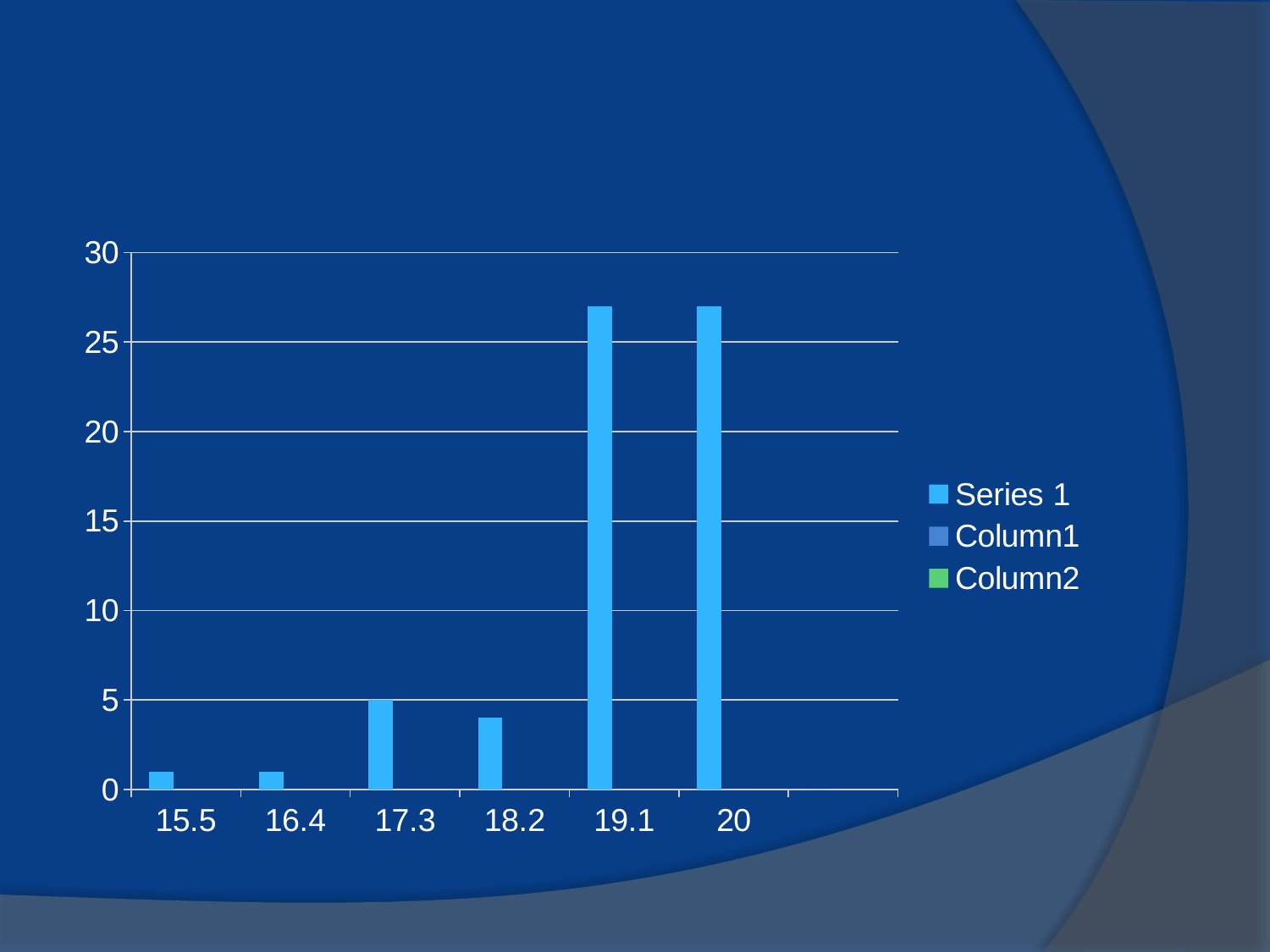
Is the value for category 15.5 greater or less than 5? less Is the value for category 19.1 greater or less than 25? greater What is the value of the bar for category 17.3? 5 How many series does the chart's legend list? 3 Which category has the larger value, 19.1 or 17.3? 19.1 What is the first entry listed in the chart's legend? Series 1 How many categories are shown on the x axis of the chart? 6 What kind of chart is shown on the slide? bar chart Is the value for category 18.2 greater or less than 5? less Which category has the larger value, 18.2 or 15.5? 18.2